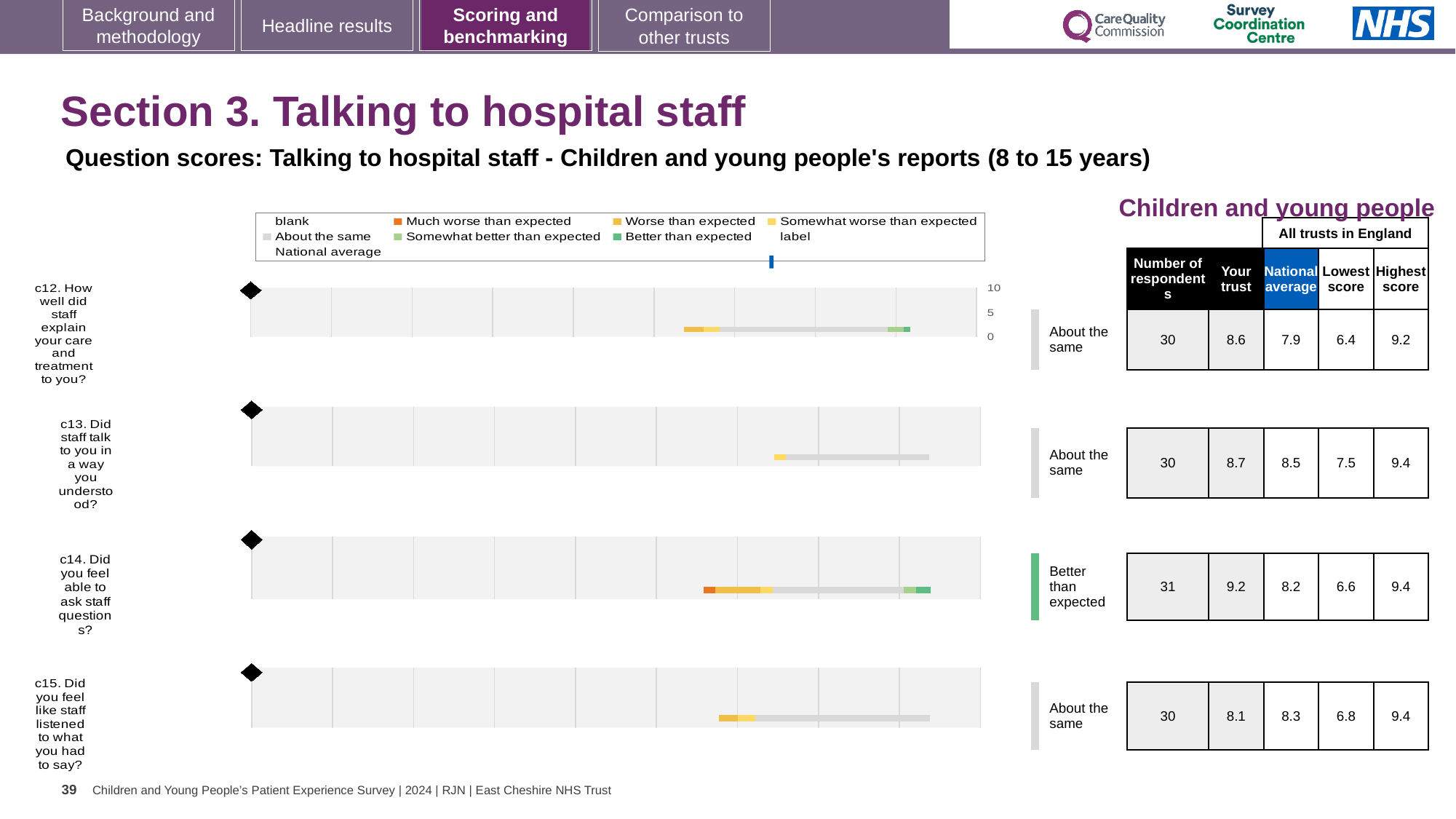
How many entries does the chart legend list? 9 Which question has the lowest 'Your trust' score in the table? c15 Which legend entry is shown in orange? Much worse than expected What is the highest tick value shown on the chart axis? 10 How many questions (c12 to c15) are plotted on the slide? 4 According to the table, what is the 'Your trust' score for c14 (Did you feel able to ask staff questions?)? 9.2 What is the difference between the 'Your trust' score and the national average for c14? 1.0 Which question has the highest 'Your trust' score in the table? c14 For c13, which is larger: the 'Your trust' score or the national average? Your trust According to the table, what is the national average for c13 (Did staff talk to you in a way you understood?)? 8.5 Which question is rated 'Better than expected' on the slide? c14 What kind of chart is used to show the question scores on this slide? bar chart